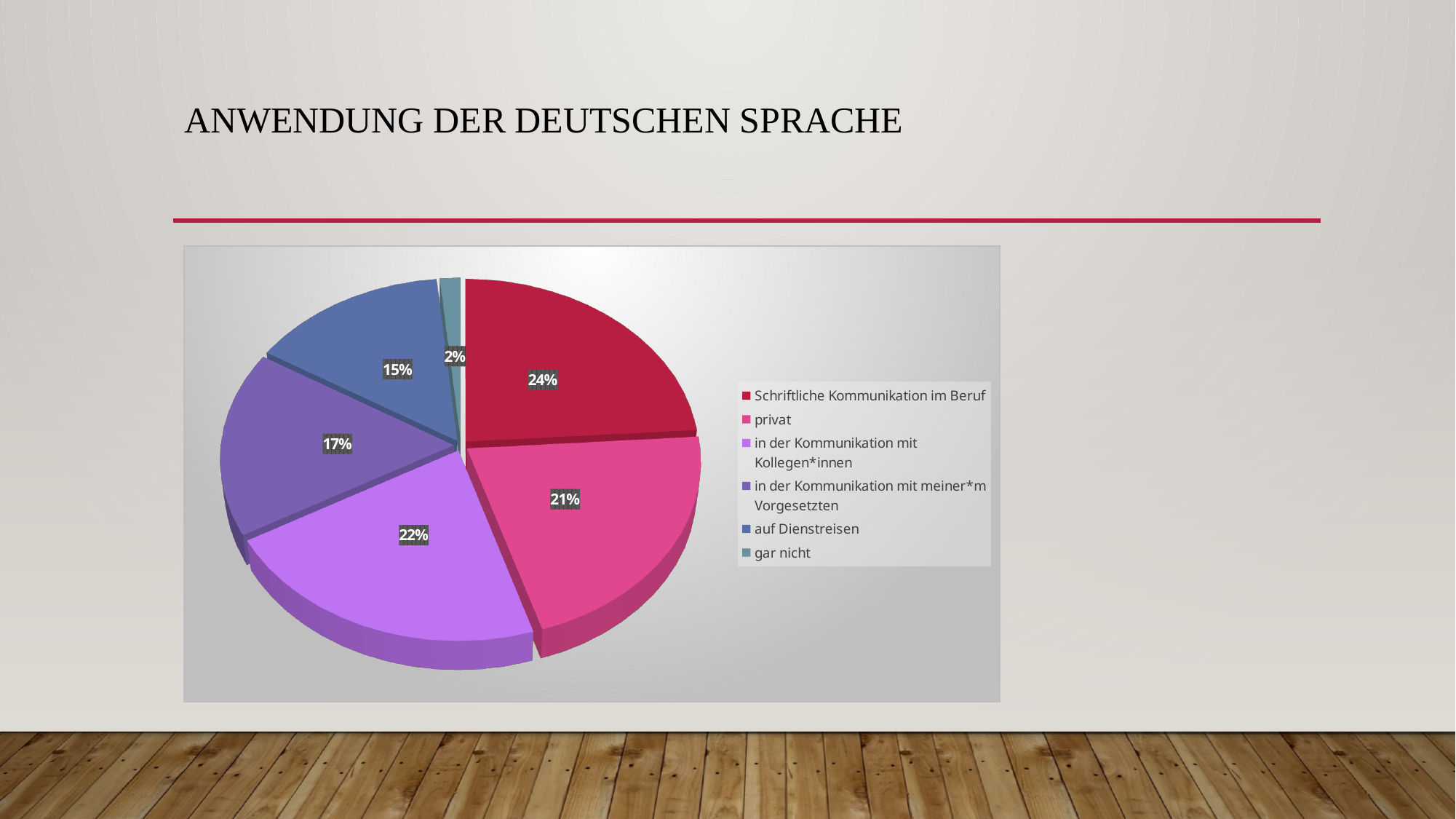
What share of the pie does "gar nicht" have? 2% Which is larger, the share for "privat" or the share for "in der Kommunikation mit meiner*m Vorgesetzten"? privat What share of the pie does "privat" have? 21% Which category has the largest share of the pie? Schriftliche Kommunikation im Beruf What is the title of the slide containing the chart? Anwendung der deutschen Sprache What share of the pie does "auf Dienstreisen" have? 15% Which category has the smallest share of the pie? gar nicht How many categories does the legend list? 6 What share of the pie does "in der Kommunikation mit Kollegen*innen" have? 22% What kind of chart is shown on the slide? Pie chart What share of the pie does "Schriftliche Kommunikation im Beruf" have? 24% What is the difference in percentage points between "Schriftliche Kommunikation im Beruf" and "auf Dienstreisen"? 9